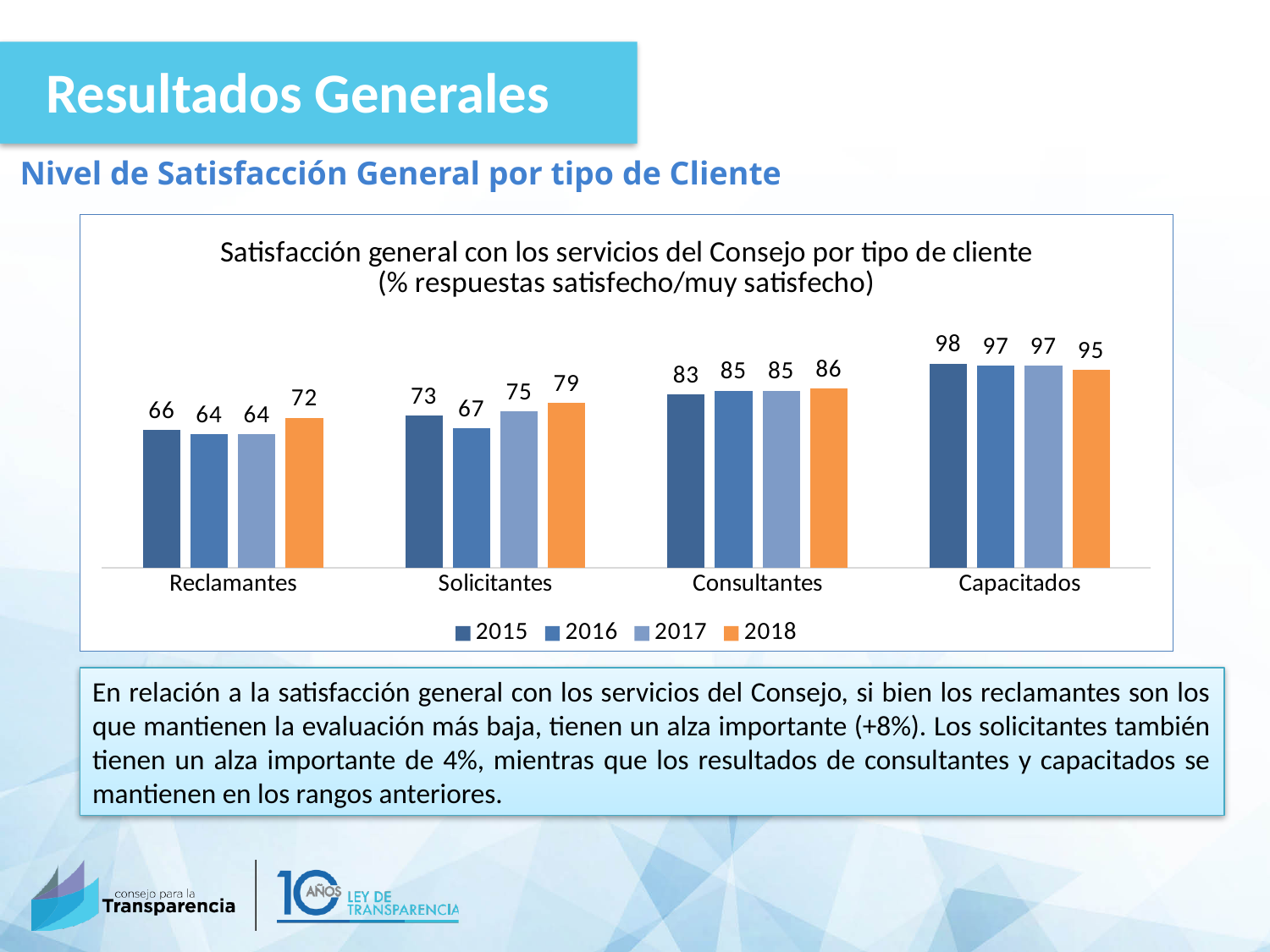
Which is larger for Solicitantes: the 2015 value or the 2017 value? 2017 What kind of chart is shown? Bar chart What is the value for Reclamantes in 2018? 72 Which year is shown in orange in the legend? 2018 How many client types are shown on the x axis? 4 What is the value for Solicitantes in 2016? 67 What is the difference between the 2018 and 2015 values for Reclamantes? 6 Which client type has the highest value in 2018? Capacitados How many series does the legend list? 4 What is the value for Capacitados in 2015? 98 Which client type has the lowest value in 2015? Reclamantes What is the value for Consultantes in 2017? 85